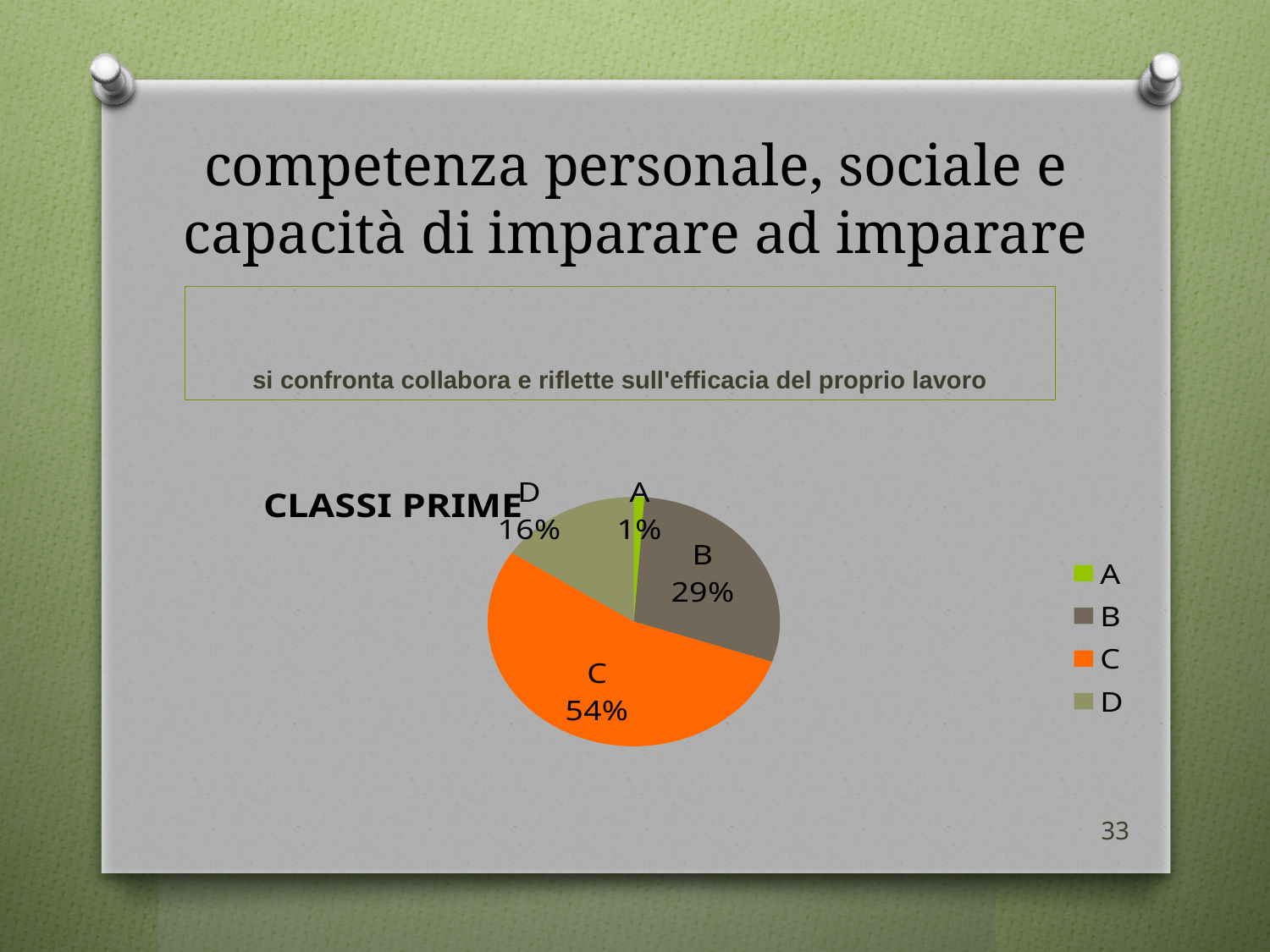
What is the difference in percentage points between slice C and slice B? 25 What percentage does slice B represent? 29% What kind of chart is shown on the slide? pie chart How many categories does the legend list? 4 What percentage does slice A represent? 1% Which is larger, the share for B or the share for D? B What percentage does slice D represent? 16% What is the title of the chart? CLASSI PRIME Which category has the largest share of the pie? C What percentage does slice C represent? 54% Which category has the smallest share of the pie? A What colour is the slice for category C? orange